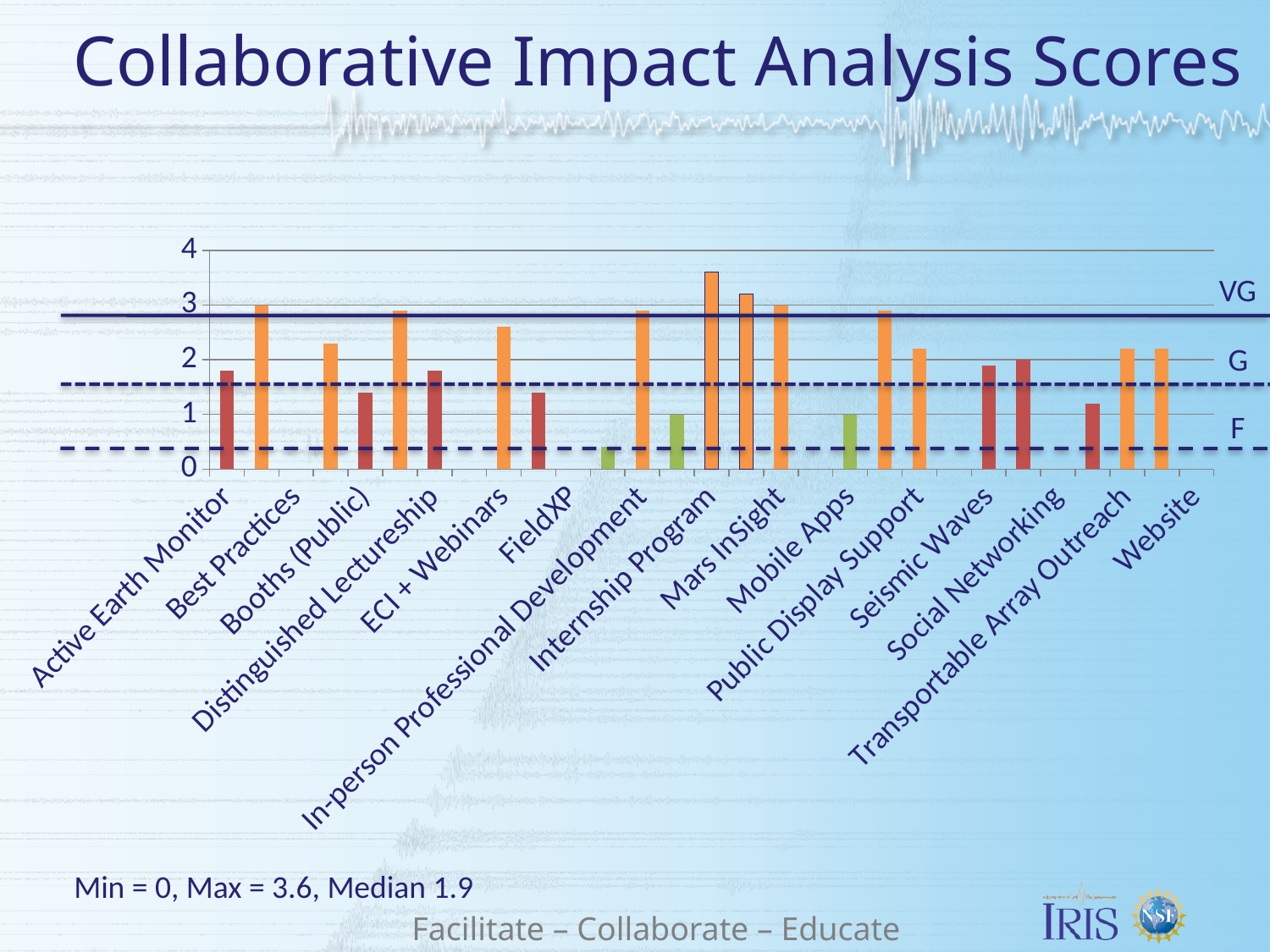
What is the maximum score reported on the slide? 3.6 What is the minimum score reported on the slide? 0 Which category has the tallest bar in the chart? Internship Program What median score is reported on the slide? 1.9 What is the highest value shown on the y axis of the chart? 4 What kind of chart is shown on the slide? bar chart Is the tallest bar for Internship Program greater or less than 3? greater What is the title of the chart? Collaborative Impact Analysis Scores What are the labels of the three horizontal reference lines on the chart, from top to bottom? VG, G, F How many categories are labelled along the x axis of the chart? 15